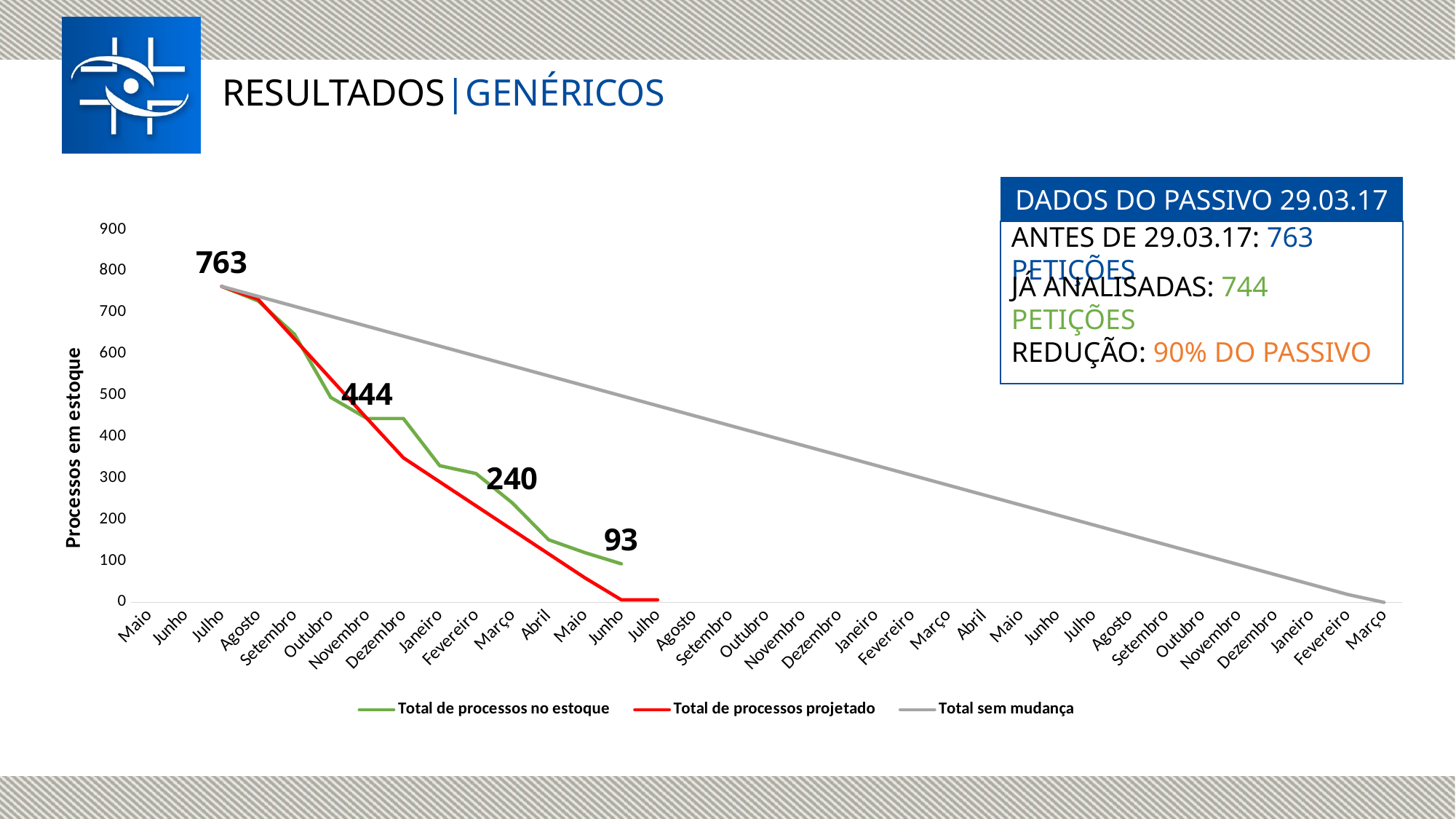
How many series does the chart legend list? 3 What is the last data label shown on the 'Total de processos no estoque' line, at Junho? 93 Is the value of 'Total de processos no estoque' at Abril greater or less than 200? less What is the difference between the first labelled value (763) and the last labelled value (93) on the green line? 670 At Junho, which series has the higher value: 'Total de processos no estoque' or 'Total de processos projetado'? Total de processos no estoque What is the first data label shown on the 'Total de processos no estoque' line, at Julho? 763 What is the title of the vertical axis? Processos em estoque What type of chart is shown on the slide? line chart Which of the four data labels printed on the chart is the highest? 763 Does the 'Total de processos no estoque' line rise or fall from Julho to Junho? fall Which of the four data labels printed on the chart is the lowest? 93 Is the value of 'Total de processos projetado' at Dezembro greater or less than 300? greater